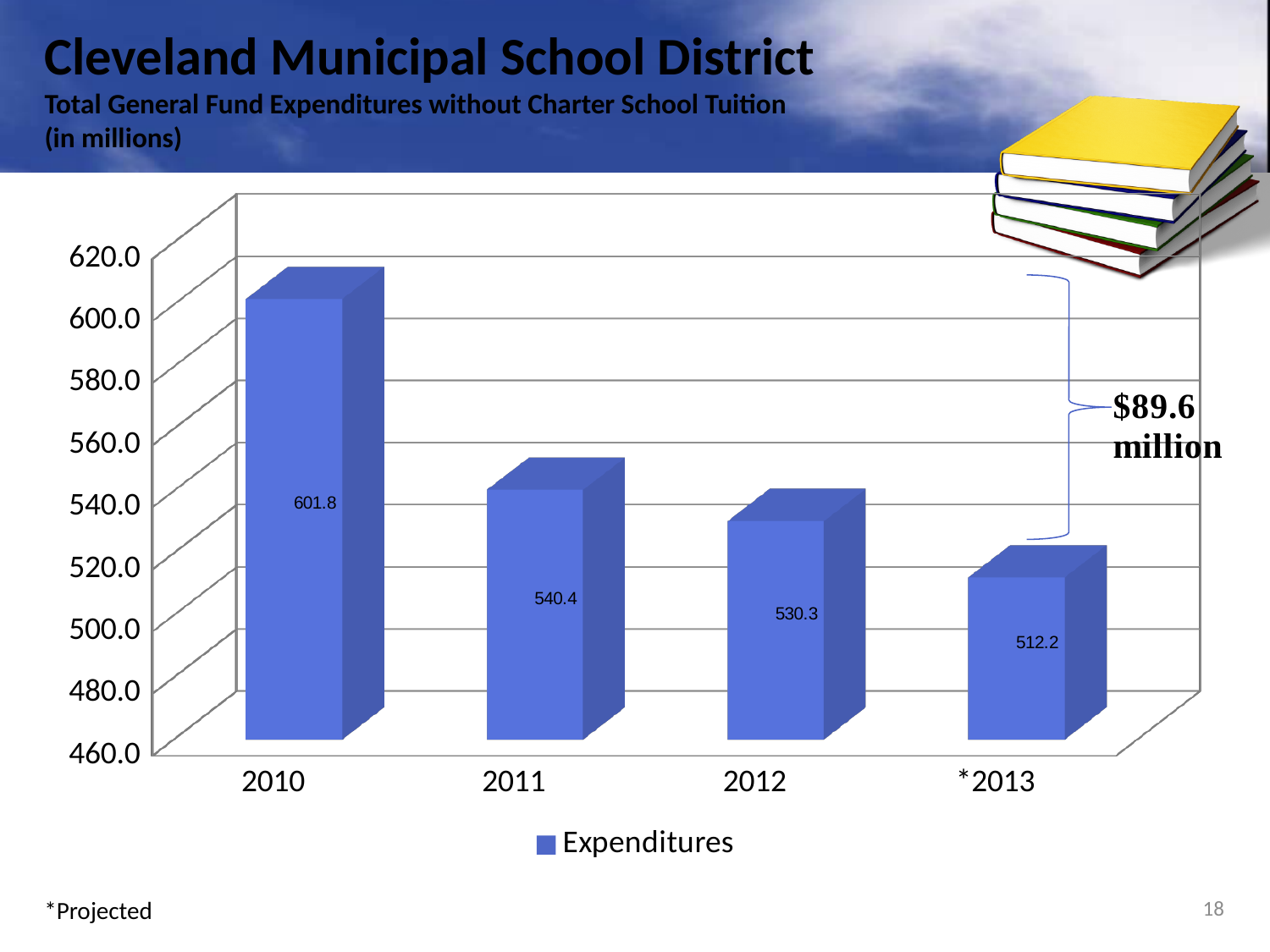
How many series does the legend list? 1 What is the expenditure value for 2010? 601.8 Which year has the highest expenditures? 2010 What is the expenditure value for 2011? 540.4 How many years are shown on the x axis? 4 What is the expenditure value for 2012? 530.3 What kind of chart is shown? bar chart Do the expenditure values rise or fall from 2010 to *2013? fall What is the difference between the 2010 and *2013 expenditure values? 89.6 What is the projected expenditure value for *2013? 512.2 Which is larger, the expenditure value for 2011 or for 2012? 2011 Which year has the lowest expenditures? *2013